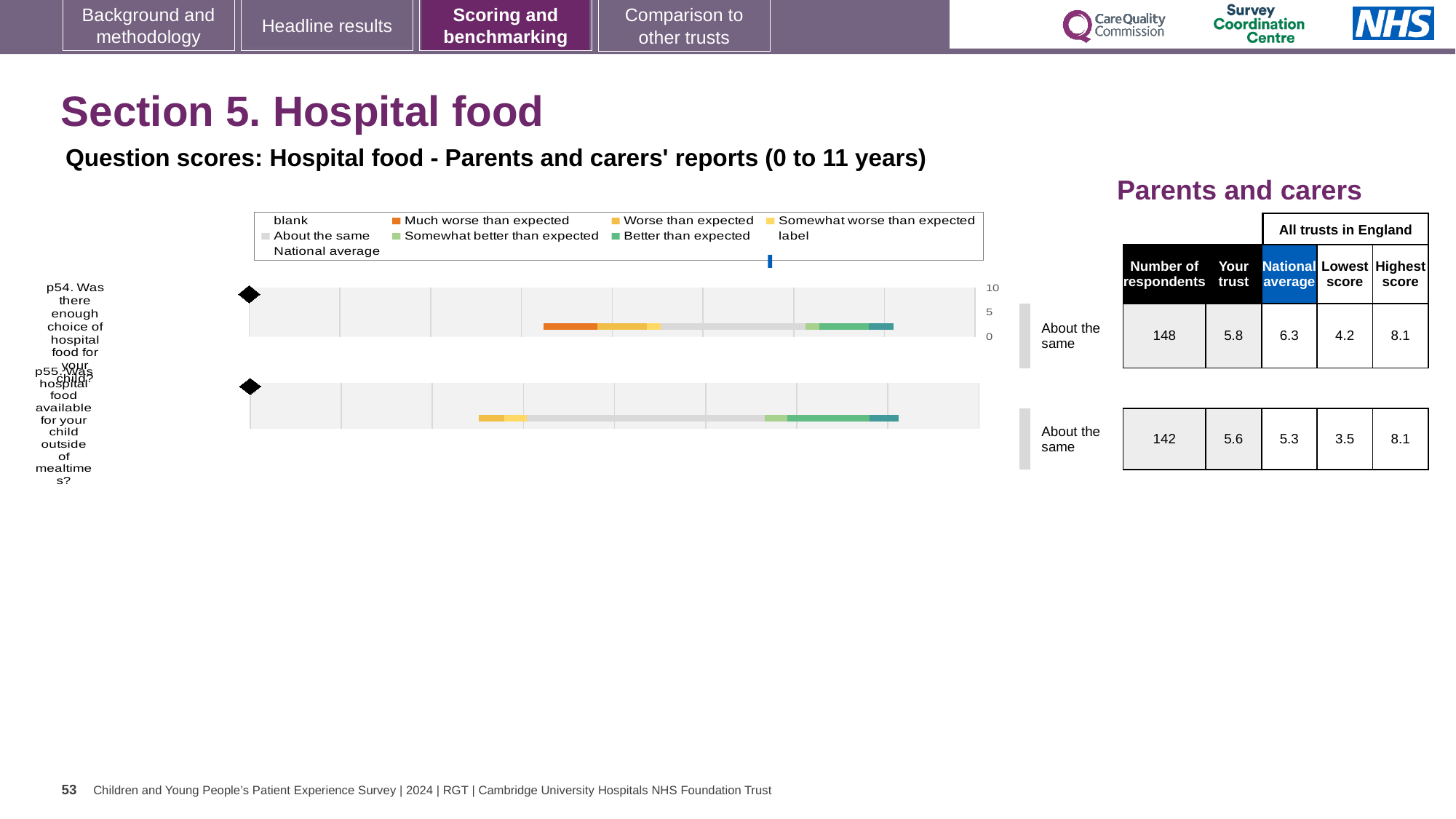
In the table beside the chart, what is the lowest score across all trusts in England for p55? 3.5 In the table beside the chart, what is the 'Your trust' score for p54 (enough choice of hospital food)? 5.8 In the table beside the chart, what is the difference between the highest score and the lowest score for p54? 3.9 What kind of chart is shown on the slide? bar chart In the table beside the chart, which is larger for p54: the trust's score or the national average? national average In the table beside the chart, what is the national average for p55 (hospital food available outside of mealtimes)? 5.3 In the table beside the chart, what benchmark category is given for both p54 and p55? About the same Which legend entry is shown in orange? Much worse than expected What is the title of the chart section above the chart? Question scores: Hospital food - Parents and carers' reports (0 to 11 years) In the table beside the chart, how many respondents answered p54? 148 How many questions (categories) are plotted in the chart? 2 How many entries does the chart legend list? 9